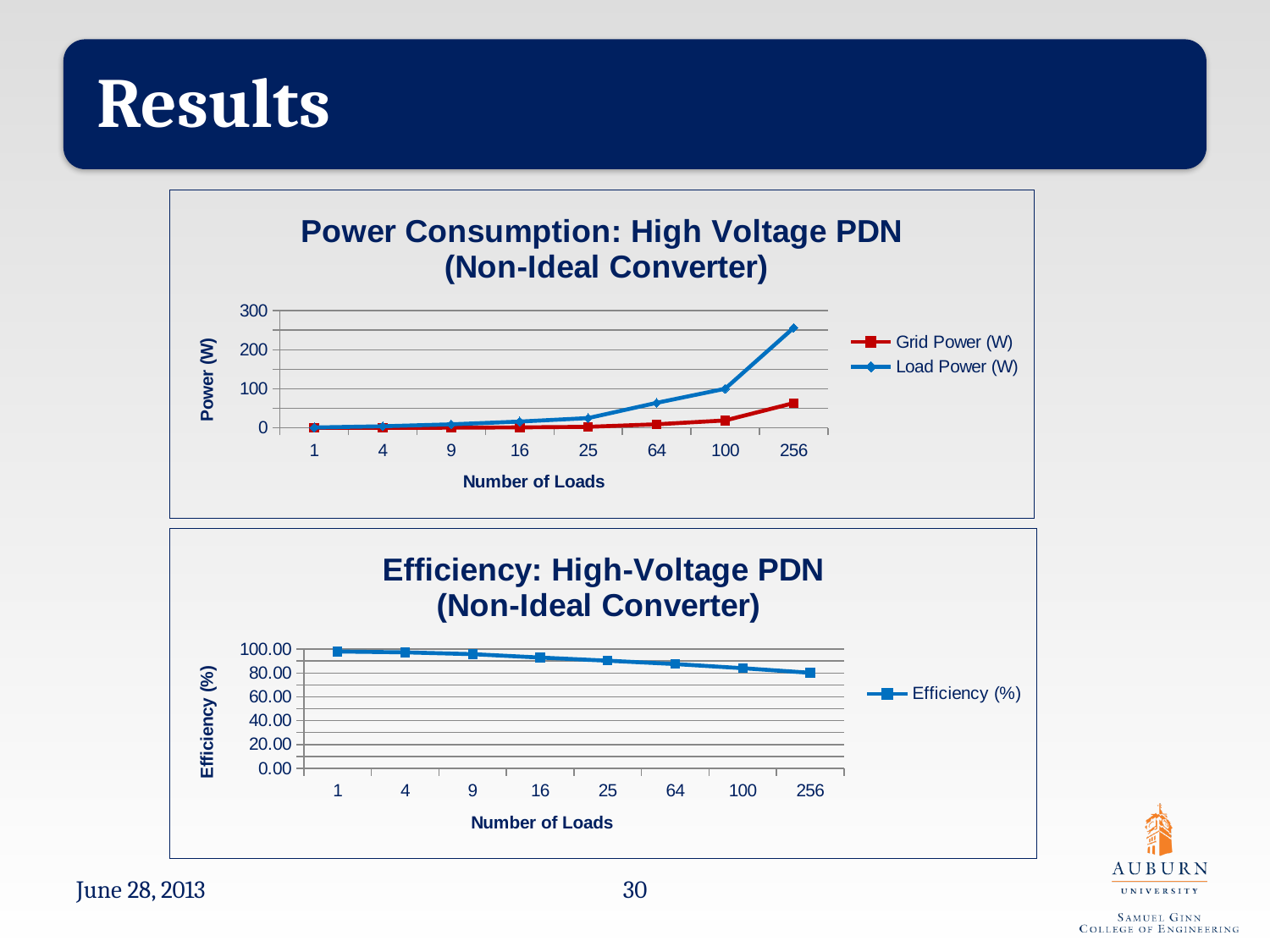
What kind of chart is the 'Power Consumption: High Voltage PDN (Non-Ideal Converter)' chart? line chart How many Number of Loads categories are shown on the x axis of the 'Power Consumption: High Voltage PDN (Non-Ideal Converter)' chart? 8 In the 'Power Consumption: High Voltage PDN (Non-Ideal Converter)' chart, which series is larger at 256 loads, Grid Power (W) or Load Power (W)? Load Power (W) In the 'Efficiency: High-Voltage PDN (Non-Ideal Converter)' chart, is the Efficiency (%) value at 1 load greater or less than 80.00? greater What is the y-axis label of the 'Efficiency: High-Voltage PDN (Non-Ideal Converter)' chart? Efficiency (%) In the 'Efficiency: High-Voltage PDN (Non-Ideal Converter)' chart, do the Efficiency (%) values rise or fall as the Number of Loads increases? fall In the 'Efficiency: High-Voltage PDN (Non-Ideal Converter)' chart, at which Number of Loads is Efficiency (%) lowest? 256 How many series does the legend of the 'Power Consumption: High Voltage PDN (Non-Ideal Converter)' chart list? 2 In the 'Power Consumption: High Voltage PDN (Non-Ideal Converter)' chart, is the Load Power (W) value at 256 loads greater or less than 200? greater In the 'Power Consumption: High Voltage PDN (Non-Ideal Converter)' chart, do the Load Power (W) values rise or fall as the Number of Loads increases? rise In the 'Power Consumption: High Voltage PDN (Non-Ideal Converter)' chart, at which Number of Loads is Load Power (W) highest? 256 In the 'Power Consumption: High Voltage PDN (Non-Ideal Converter)' chart, is the Grid Power (W) value at 256 loads greater or less than 100? less